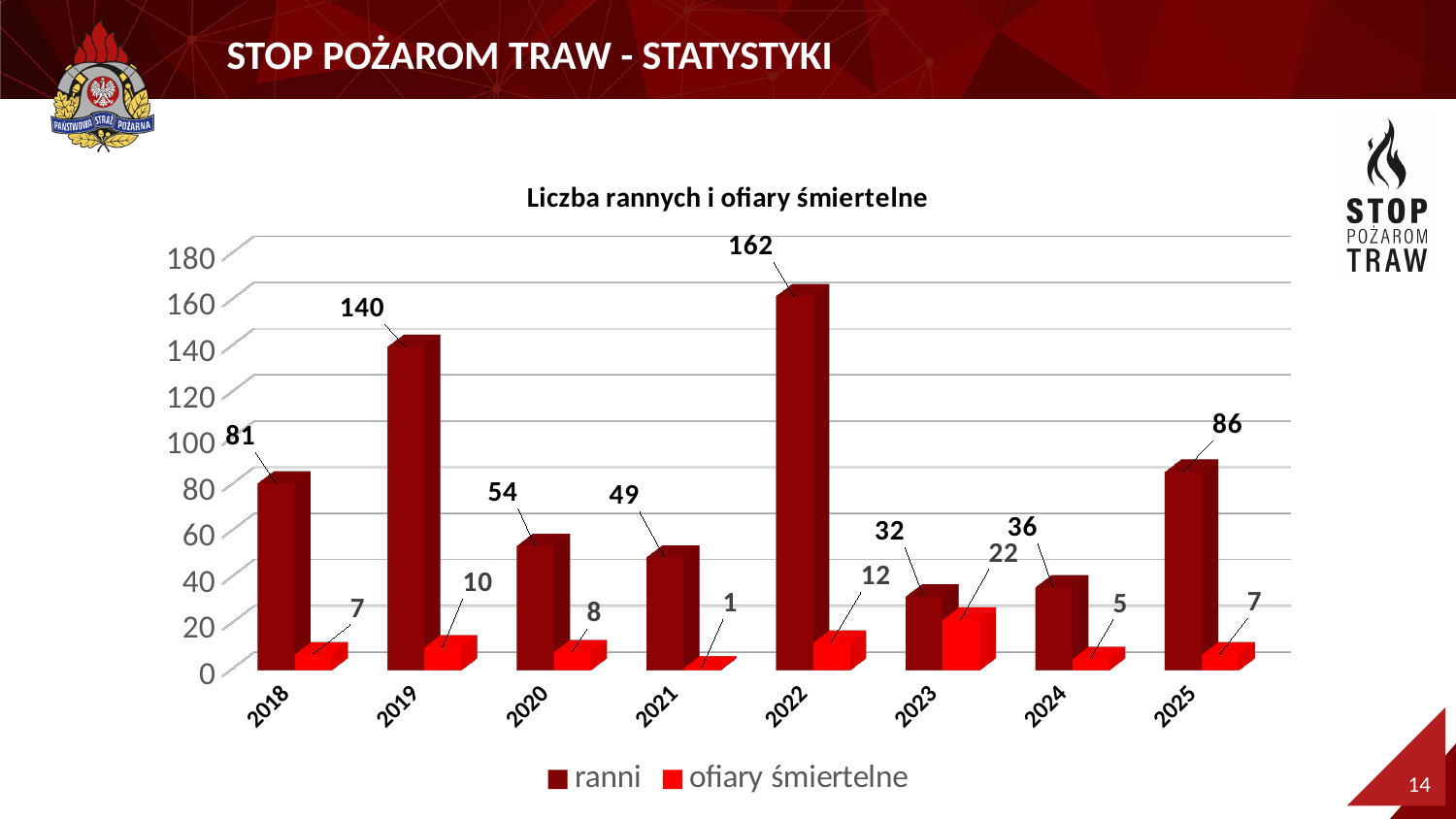
Which is larger, the 'ranni' value for 2018 or for 2025? 2025 What is the difference between the 'ranni' values for 2022 and 2019? 22 How many series does the legend list? 2 Which year has the lowest value for 'ofiary śmiertelne'? 2021 What kind of chart is shown on the slide? bar chart What is the value for 'ranni' in 2022? 162 What is the title of the chart? Liczba rannych i ofiary śmiertelne How many years are shown on the x axis? 8 Is the 'ranni' value for 2019 greater or less than 120? greater What is the value for 'ranni' in 2025? 86 What is the value for 'ofiary śmiertelne' in 2023? 22 Which year has the highest value for 'ranni'? 2022